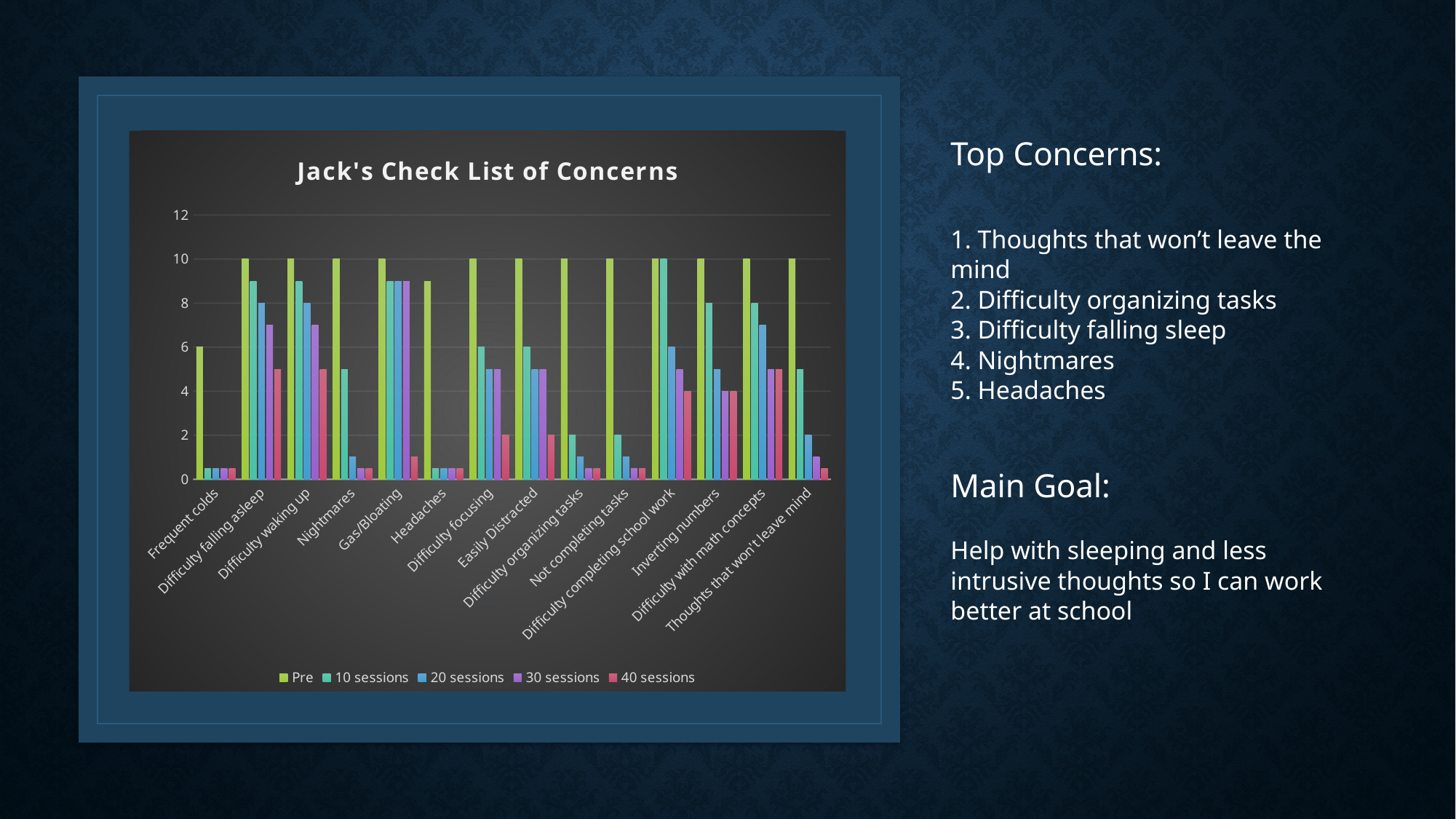
What is the Pre value for Frequent colds? 6 Is the 10 sessions value for Inverting numbers greater or less than 6? greater What is the 40 sessions value for Difficulty completing school work? 4 What is the Pre value for Nightmares? 10 How many series does the legend list? 5 Which category has the lowest Pre value? Frequent colds What is the title of the chart? Jack's Check List of Concerns How many concern categories are shown on the x axis? 14 Which is larger: the Pre value for Headaches or the Pre value for Frequent colds? Headaches What is the 20 sessions value for Difficulty falling asleep? 8 What kind of chart is shown on the slide? bar chart What is the difference between the Pre value for Nightmares and the Pre value for Frequent colds? 4